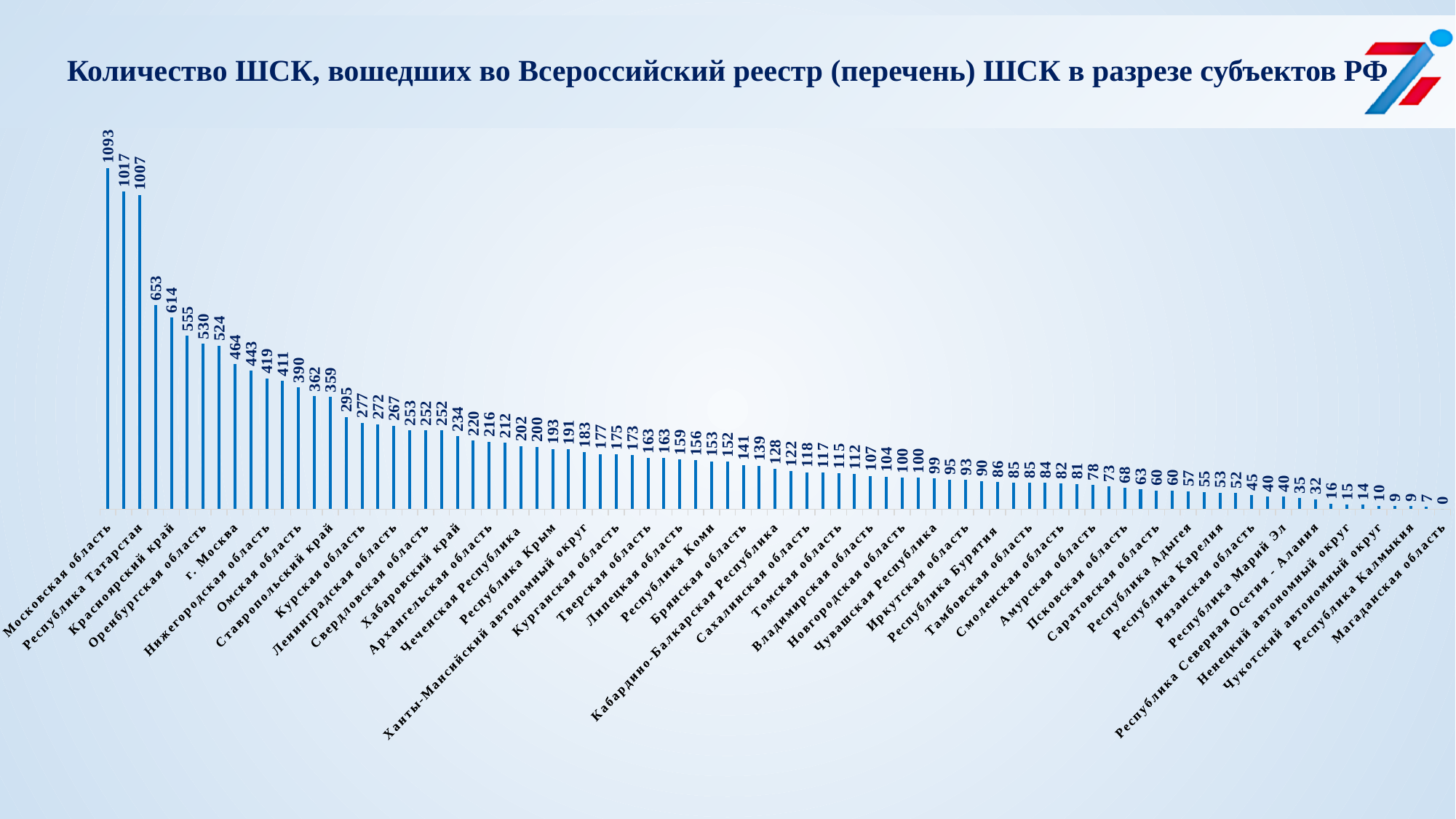
What is the value for Магаданская область? 0 What colour are the bars in the chart? blue What is the difference between the highest bar (1093) and the second-highest bar (1017)? 76 What type of chart is shown on the slide? bar chart What is the value for Московская область? 1093 Which is larger, the value for Московская область or the value for Магаданская область? Московская область What is the value of the second-highest bar in the chart? 1017 What is the title of the chart? Количество ШСК, вошедших во Всероссийский реестр (перечень) ШСК в разрезе субъектов РФ Which region has the lowest value in the chart? Магаданская область How many bars are plotted in the chart? 85 Do the values rise or fall moving from left to right along the x axis? fall Which region has the highest number of ШСК in the chart? Московская область